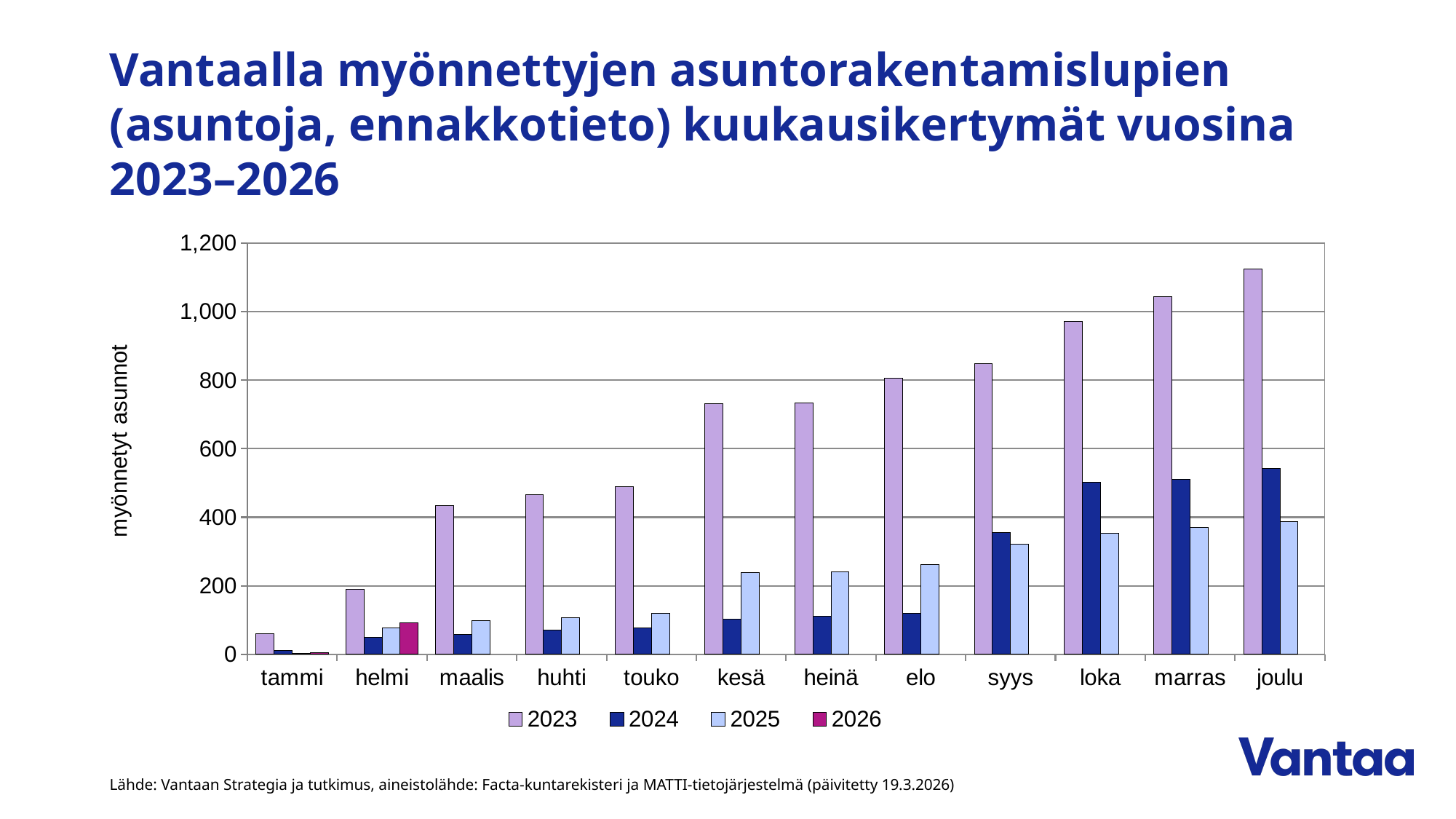
In joulu, which is larger: the 2024 value or the 2025 value? 2024 Is the 2024 value for loka greater or less than 400? greater In which month is the 2023 value highest? joulu In which month is the 2023 value lowest? tammi How many months are shown on the x axis? 12 How many series does the legend list? 4 What kind of chart is shown on the slide? bar chart What is the label on the y axis? myönnetyt asunnot Do the 2023 values rise or fall from tammi to joulu? rise In kesä, which is larger: the 2024 value or the 2025 value? 2025 Is the 2025 value for syys greater or less than 400? less Is the 2023 value for joulu greater or less than 1,000? greater